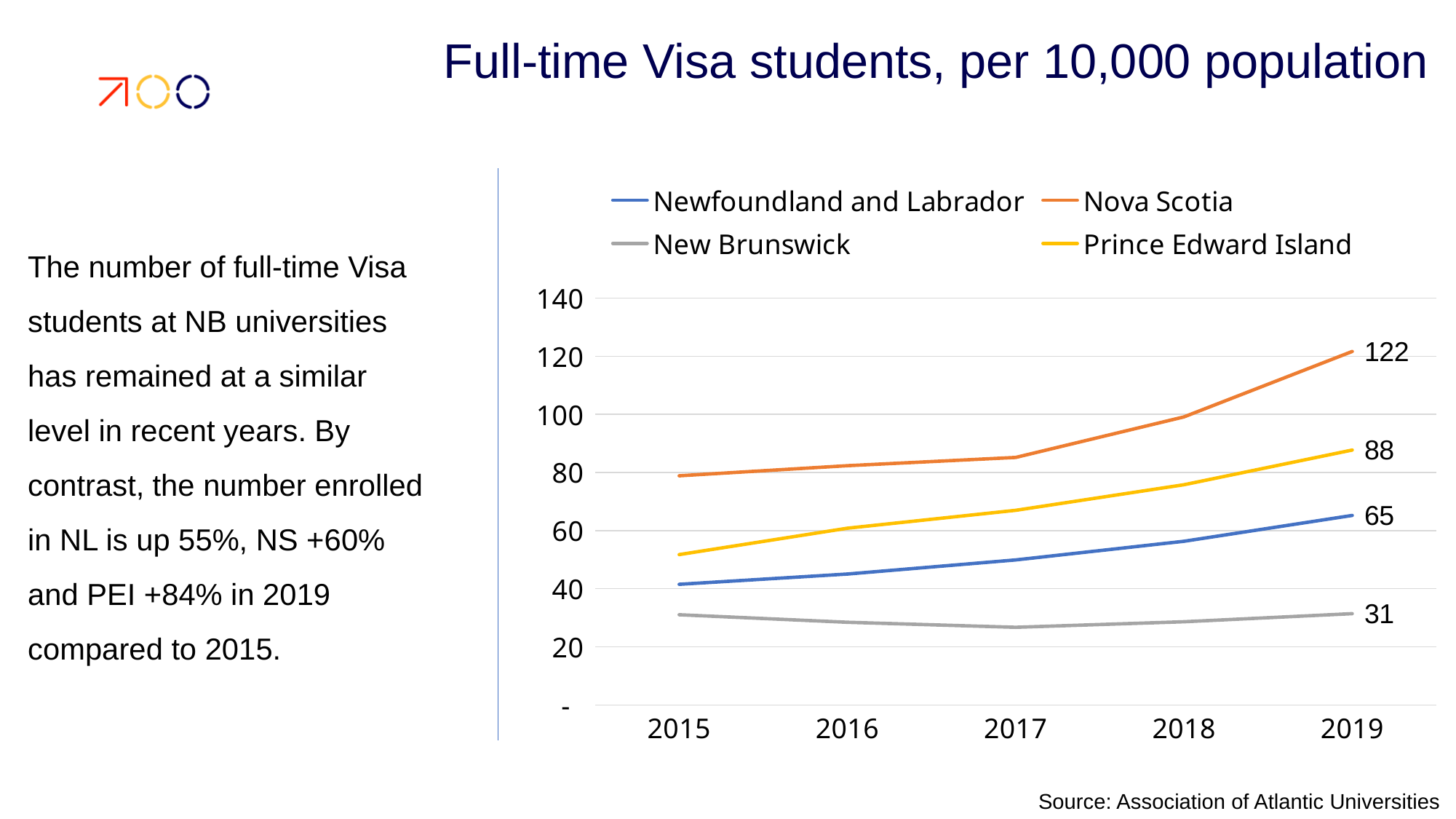
What kind of chart is shown on the slide? Line chart What is the value for Prince Edward Island in 2019? 88 What is the value for Newfoundland and Labrador in 2019? 65 What is the difference between the 2019 values for Nova Scotia and Prince Edward Island? 34 How many series does the legend list? 4 Which province has the highest value in 2019? Nova Scotia Which province has the lowest value in 2019? New Brunswick What is the value for New Brunswick in 2019? 31 Does the value for Nova Scotia rise or fall from 2015 to 2019? Rise Is the value for Nova Scotia in 2015 greater or less than 100? less What is the value for Nova Scotia in 2019? 122 Which is larger in 2019, the value for Newfoundland and Labrador or the value for New Brunswick? Newfoundland and Labrador